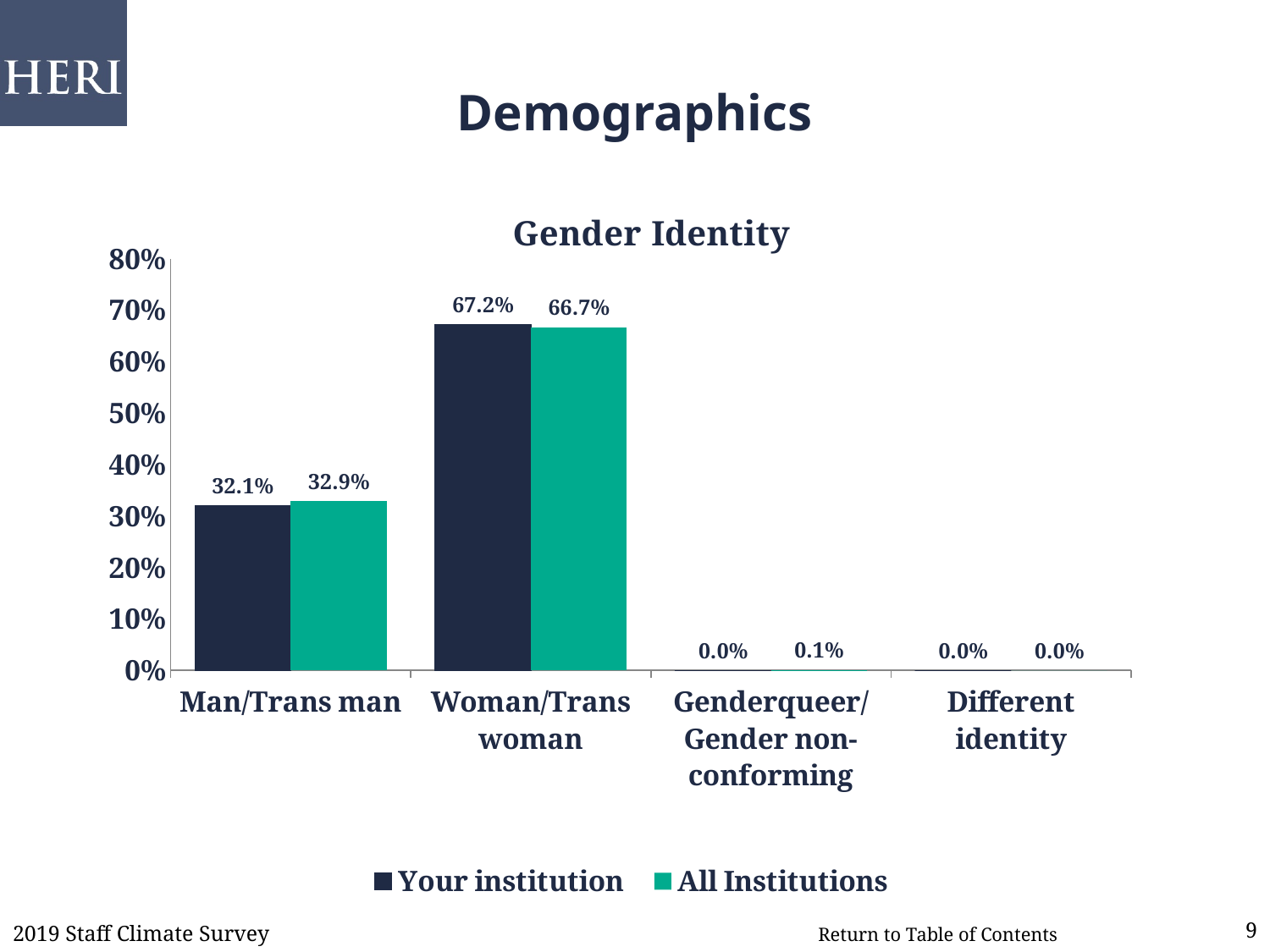
How many categories are shown on the x axis? 4 How many series does the legend list? 2 What kind of chart is shown? Bar chart What is the value for Man/Trans man for Your institution? 32.1% What is the value for Different identity for Your institution? 0.0% What is the value for Woman/Trans woman for All Institutions? 66.7% What is the value for Genderqueer/Gender non-conforming for All Institutions? 0.1% Which category has the highest value for Your institution? Woman/Trans woman What is the difference between the Your institution values for Woman/Trans woman and Man/Trans man? 35.1% What is the difference between the Your institution and All Institutions values for Man/Trans man? 0.8% Is the value for Man/Trans man for All Institutions greater or less than 30%? greater For Woman/Trans woman, which is larger: Your institution or All Institutions? Your institution